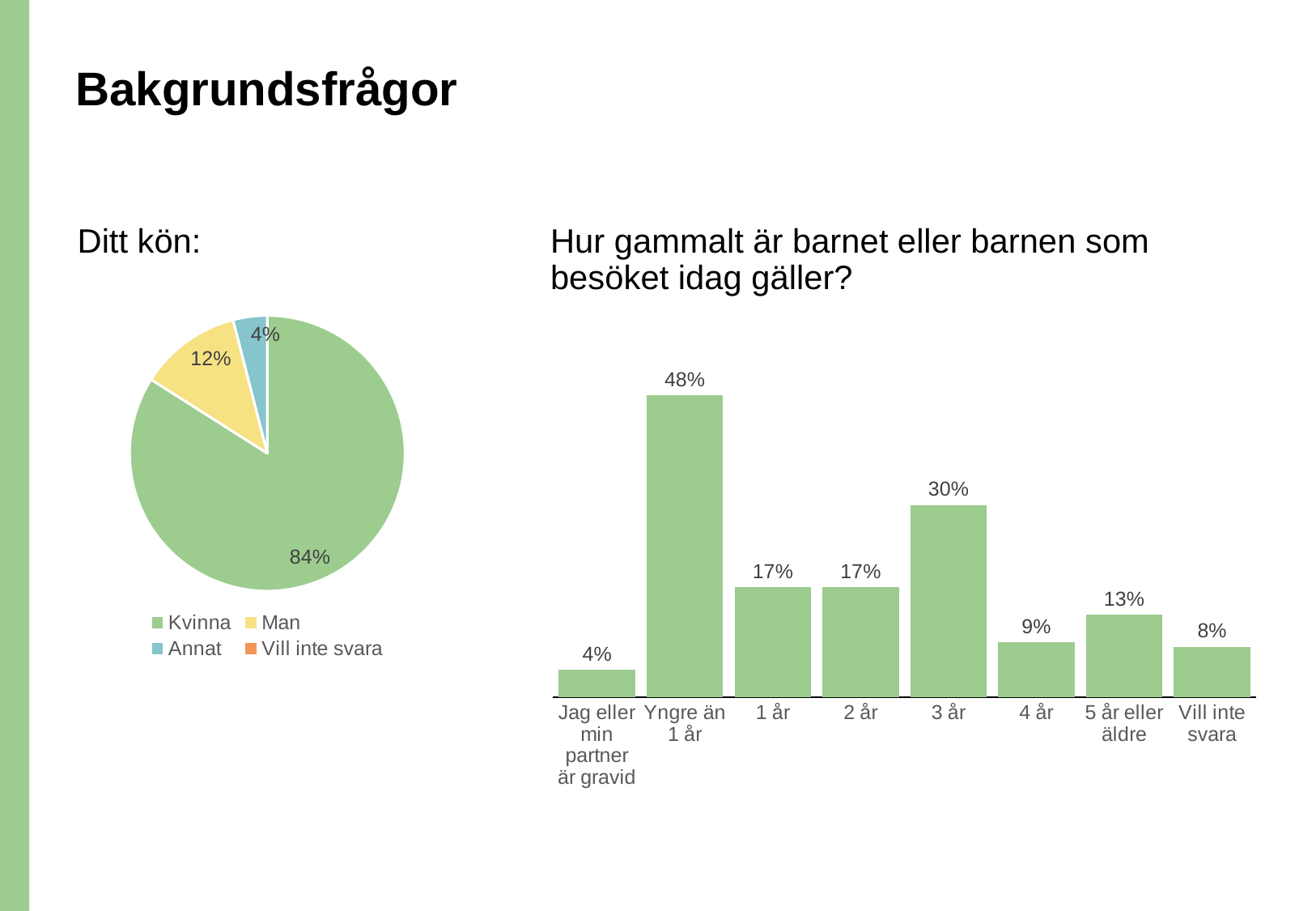
In the bar chart 'Hur gammalt är barnet eller barnen som besöket idag gäller?', which category has the lowest value? Jag eller min partner är gravid In the 'Ditt kön:' pie chart, what percentage is shown for Man? 12% In the 'Ditt kön:' pie chart, which category has the largest slice? Kvinna In the bar chart 'Hur gammalt är barnet eller barnen som besöket idag gäller?', what is the value for '3 år'? 30% In the bar chart 'Hur gammalt är barnet eller barnen som besöket idag gäller?', what is the difference between 'Yngre än 1 år' and '3 år'? 18% In the bar chart 'Hur gammalt är barnet eller barnen som besöket idag gäller?', which is larger: '4 år' or '5 år eller äldre'? 5 år eller äldre In the bar chart 'Hur gammalt är barnet eller barnen som besöket idag gäller?', what is the value for 'Yngre än 1 år'? 48% In the 'Ditt kön:' pie chart, what share is labelled for Kvinna? 84% How many categories are shown in the bar chart 'Hur gammalt är barnet eller barnen som besöket idag gäller?'? 8 How many entries does the legend of the 'Ditt kön:' pie chart list? 4 What kind of chart is the chart on the left of the slide? Pie chart What kind of chart is the chart on the right of the slide? Bar chart